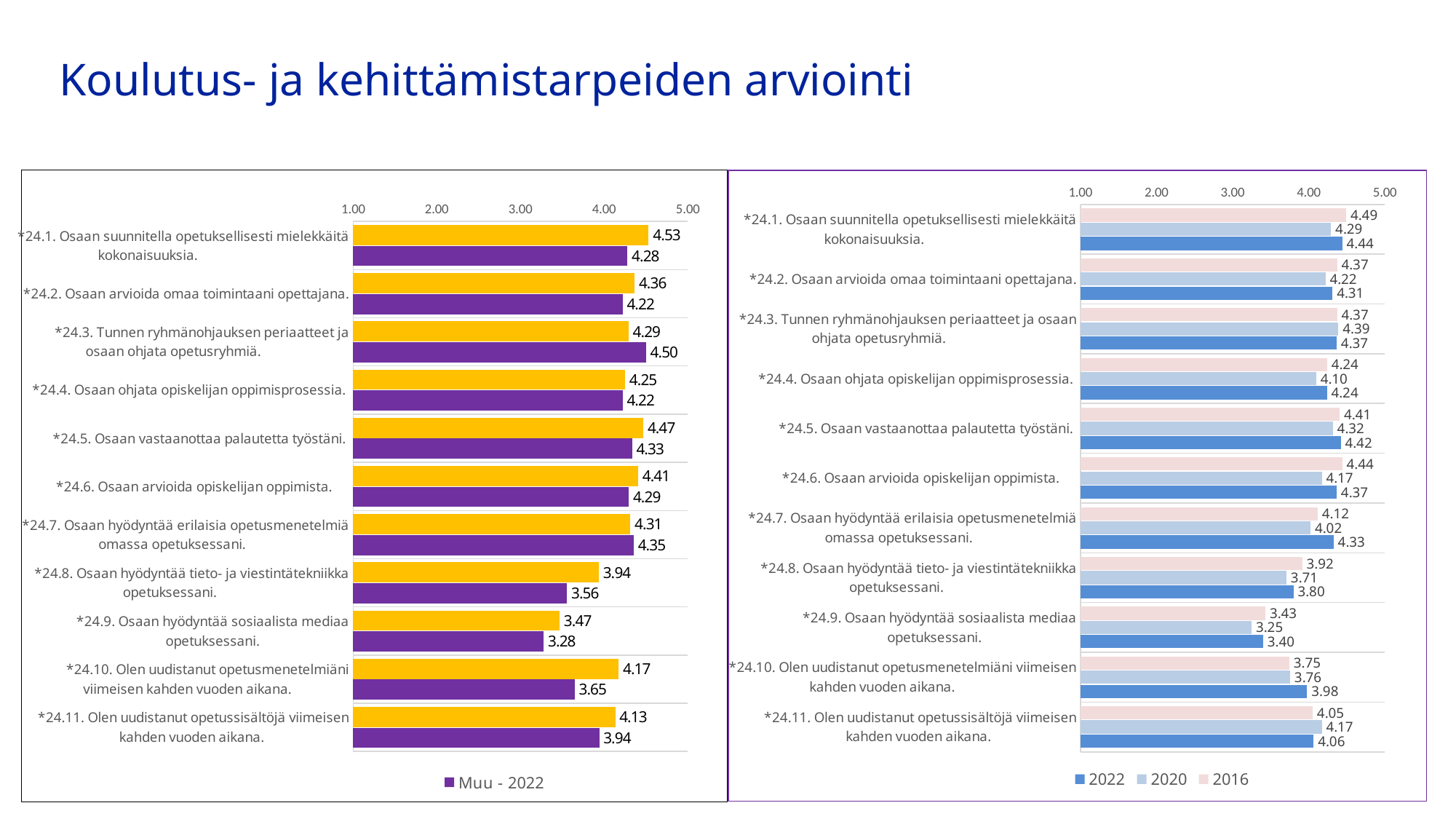
In the left chart, which category has the highest Muu - 2022 value? *24.3. Tunnen ryhmänohjauksen periaatteet ja osaan ohjata opetusryhmiä. In the left chart, what is the Muu - 2022 value for '*24.9. Osaan hyödyntää sosiaalista mediaa opetuksessani.'? 3.28 In the right chart, what is the difference between the 2022 and 2020 values for 24.6? 0.20 In the right chart, what is the 2016 value for '*24.8. Osaan hyödyntää tieto- ja viestintätekniikka opetuksessani.'? 3.92 In the left chart, what is the difference between the Muu - 2022 values for 24.1 and 24.8? 0.72 In the left chart, how many categories are shown? 11 In the right chart, what is the 2020 value for '*24.7. Osaan hyödyntää erilaisia opetusmenetelmiä omassa opetuksessani.'? 4.02 How many series does the legend of the right chart list? 3 In the right chart, which category has the lowest 2020 value? *24.9. Osaan hyödyntää sosiaalista mediaa opetuksessani. What kind of chart is the right chart? bar chart In the right chart, for 24.10, which is larger: the 2022 value or the 2016 value? 2022 In the left chart, which category has the lowest Muu - 2022 value? *24.9. Osaan hyödyntää sosiaalista mediaa opetuksessani.